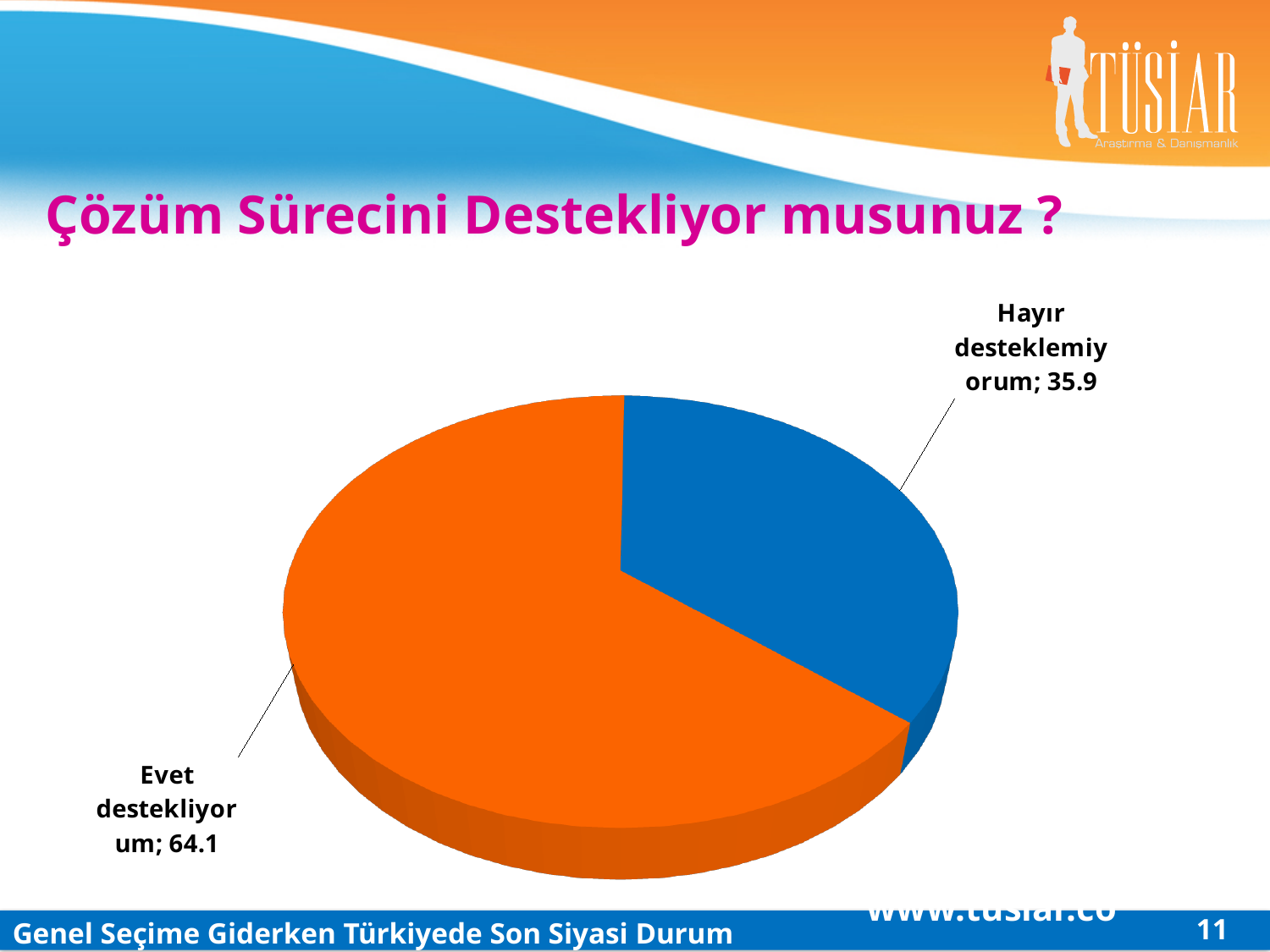
Which is larger, the value for "Evet destekliyorum" or for "Hayır desteklemiyorum"? Evet destekliyorum What is the difference between the values for "Evet destekliyorum" and "Hayır desteklemiyorum"? 28.2 What colour is the "Hayır desteklemiyorum" slice? Blue Which slice of the pie is the smallest? Hayır desteklemiyorum What is the total of the two values shown on the pie chart? 100 What is the title of the slide above the chart? Çözüm Sürecini Destekliyor musunuz ? What value is shown for "Hayır desteklemiyorum"? 35.9 What kind of chart is shown on the slide? Pie chart Which slice of the pie is the largest? Evet destekliyorum What value is shown for "Evet destekliyorum"? 64.1 How many slices does the pie chart have? 2